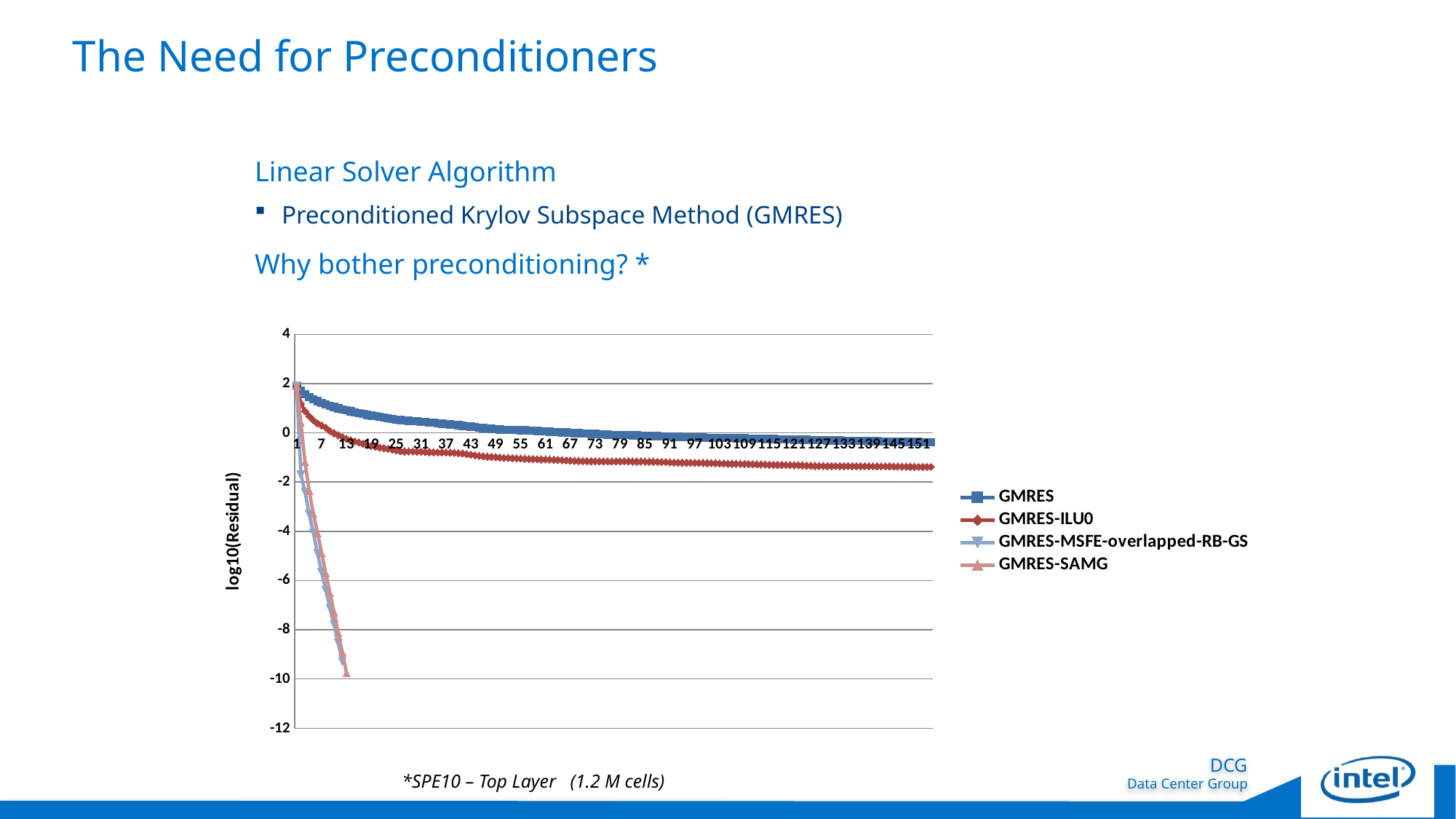
At iteration 151, which series has the higher value, GMRES or GMRES-ILU0? GMRES What is the label of the vertical axis of the chart? log10(Residual) What kind of chart is shown on the slide? line chart Is the value of the GMRES series at iteration 1 greater or less than 0? greater Is the lowest value reached by the GMRES-SAMG series greater or less than -8? less How many series does the chart legend list? 4 Does the GMRES series rise or fall as the iteration count increases along the x axis? fall Is the value of the GMRES-ILU0 series at iteration 151 greater or less than -2? greater Which series is listed last in the chart legend? GMRES-SAMG What is the largest tick value shown on the vertical axis? 4 What is the last iteration label shown on the horizontal axis? 151 Which series reaches the lowest value on the chart? GMRES-SAMG